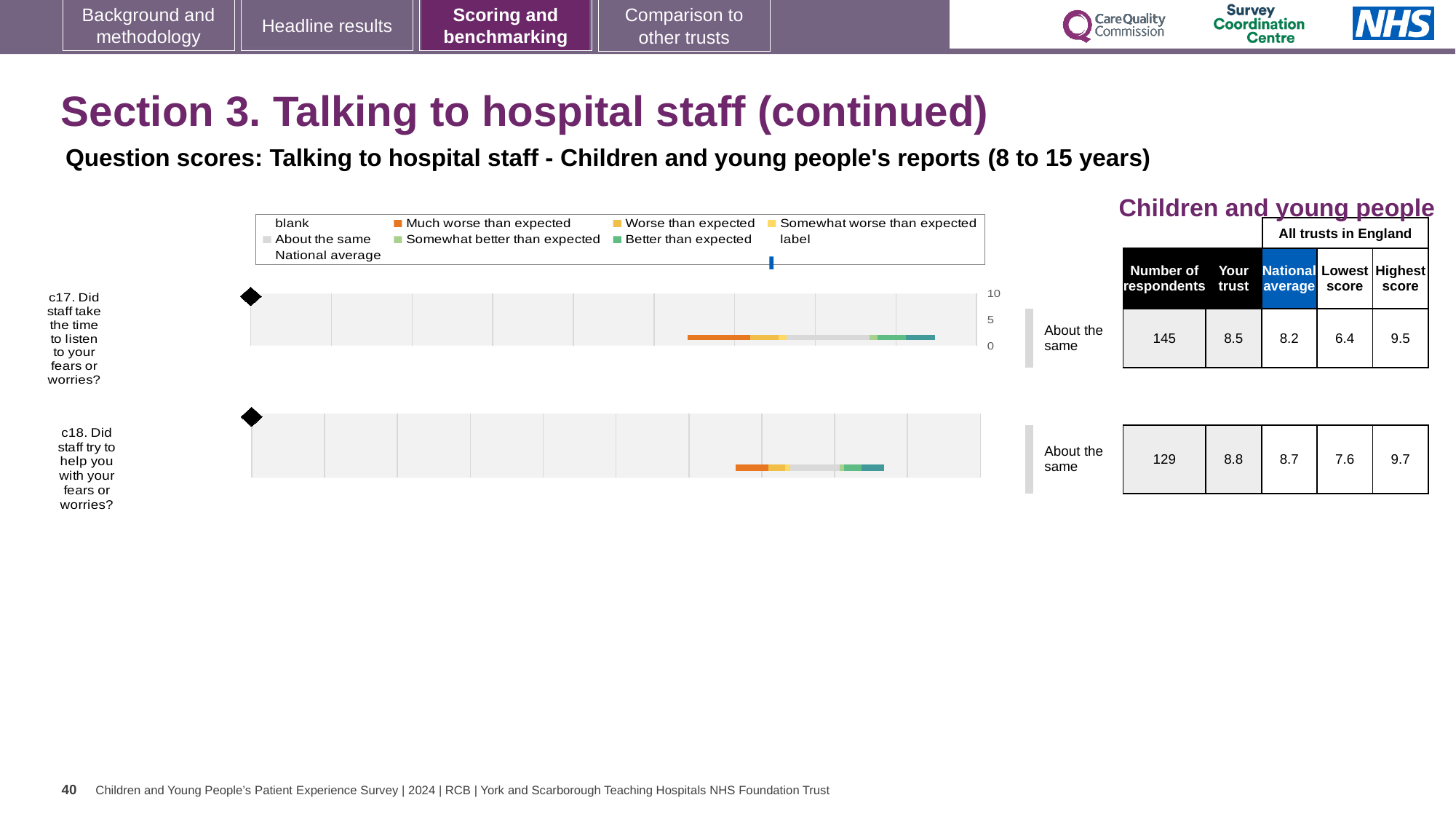
What is the difference between the highest score and the lowest score for question c18? 2.1 Which question has the higher 'Your trust' score, c17 or c18? c18 What is the highest score across all trusts in England for question c18? 9.7 What is the national average score for question c18 (Did staff try to help you with your fears or worries?)? 8.7 What is the lowest score across all trusts in England for question c17? 6.4 What kind of chart is used to show the question scores on this slide? Bar chart What benchmark category is shown next to the chart for question c17? About the same How many survey questions are plotted on this slide? 2 By how much does the trust's score for question c17 exceed the national average? 0.3 Which question had more respondents, c17 or c18? c17 What is the 'Your trust' score for question c17 (Did staff take the time to listen to your fears or worries?)? 8.5 How many respondents answered question c17? 145